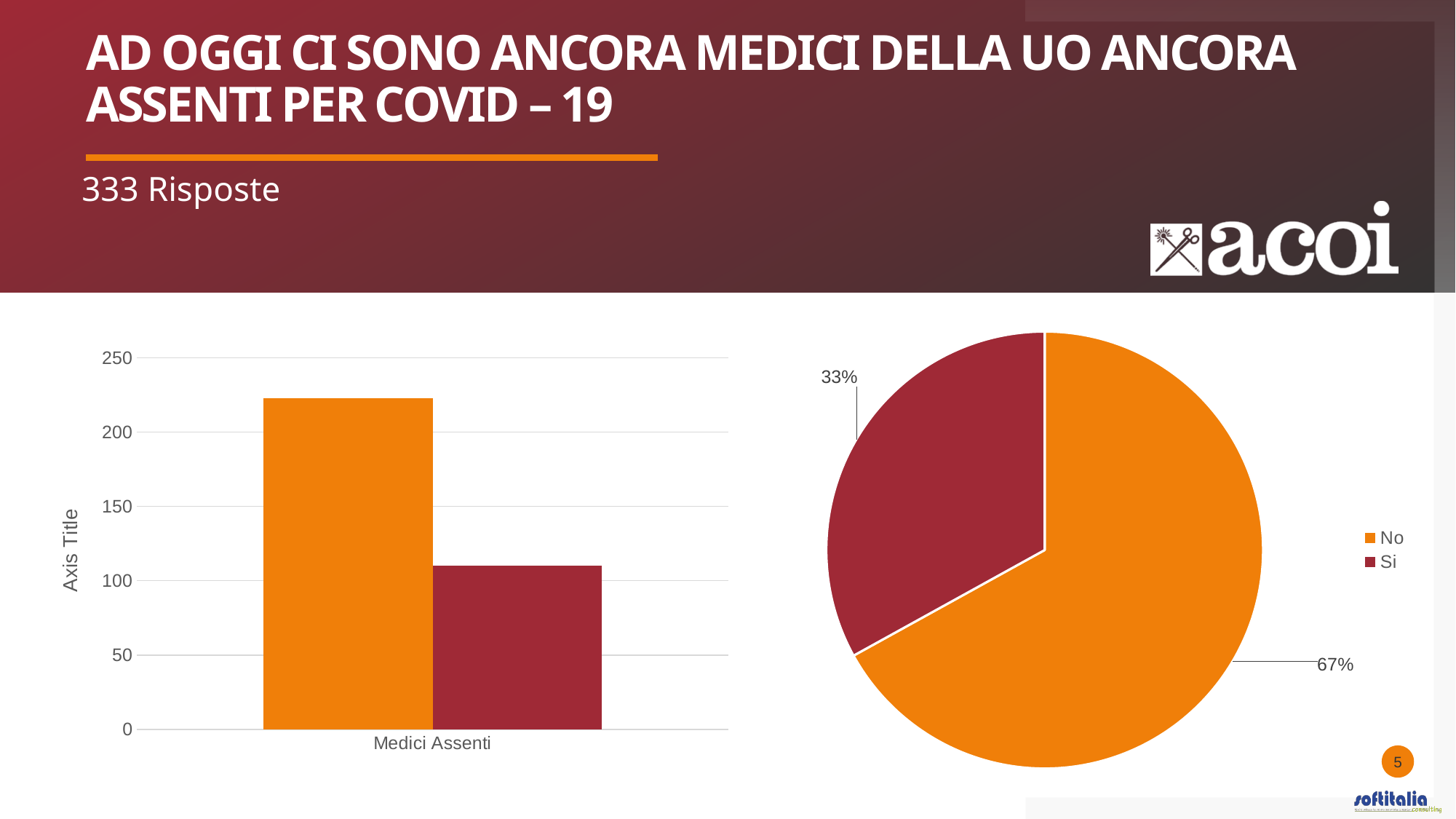
What kind of chart is the chart on the right of the slide? pie chart In the bar chart on the left, is the value of the orange bar greater or less than 200? greater In the pie chart on the right, which slice is the largest? No What kind of chart is the chart on the left of the slide? bar chart In the bar chart on the left, is the value of the red bar greater or less than 150? less In the pie chart on the right, what share of the pie does the 'Si' slice represent? 33% In the pie chart on the right, by how many percentage points does the 'No' share exceed the 'Si' share? 34 In the pie chart on the right, what share of the pie does the 'No' slice represent? 67% In the bar chart on the left, which bar is taller, the orange bar or the red bar? the orange bar In the pie chart on the right, which slice is the smallest? Si In the pie chart on the right, how many entries does the legend list? 2 In the bar chart on the left, what is the label of the category shown on the x axis? Medici Assenti